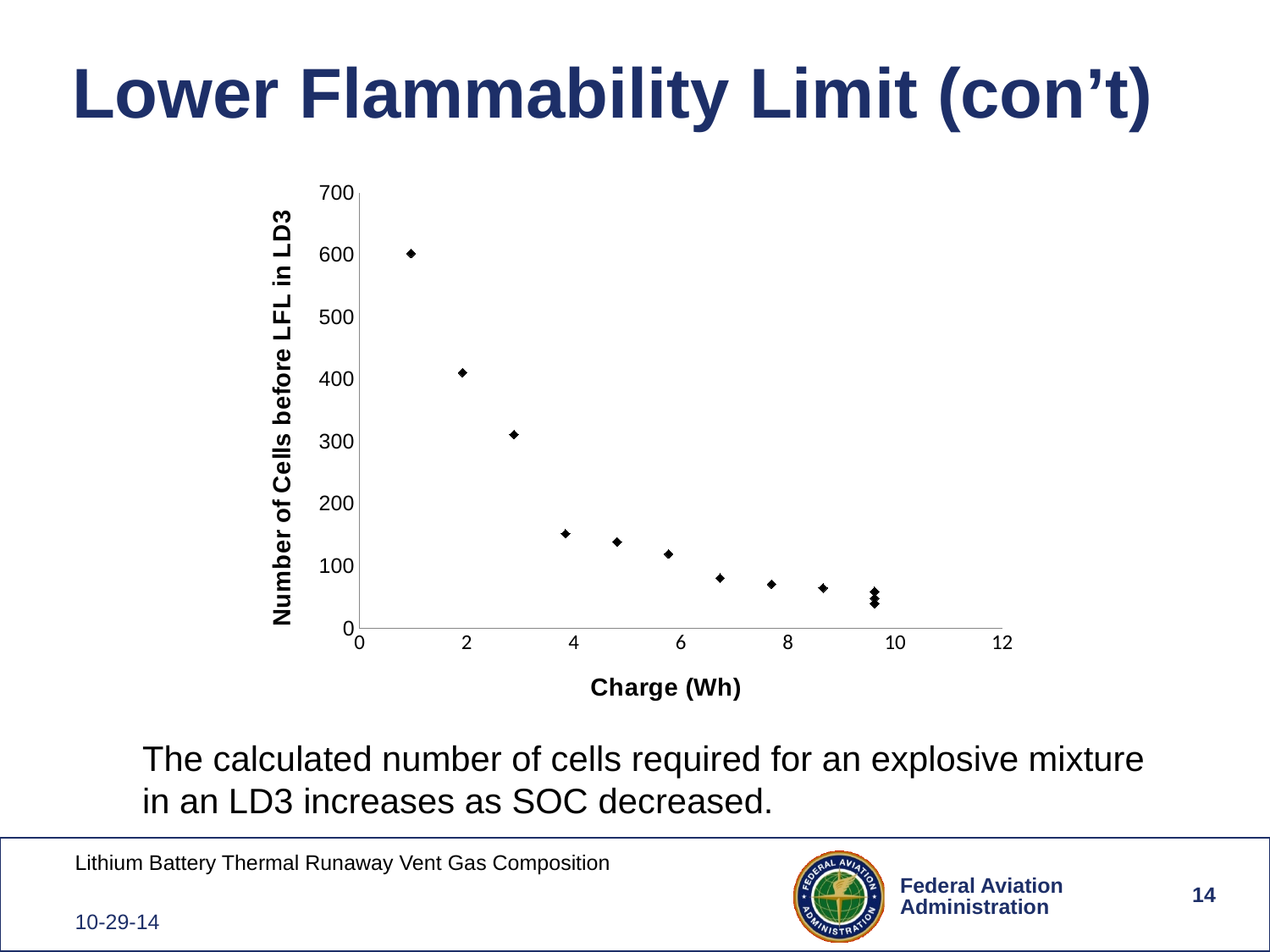
What is the label of the x axis? Charge (Wh) What kind of chart is shown on the slide? scatter chart What is the label of the y axis? Number of Cells before LFL in LD3 Is the number of cells for the point at about 3 Wh greater or less than 400? less As charge (Wh) increases along the x axis, does the number of cells before LFL rise or fall? fall Is the number of cells for the point at about 4 Wh greater or less than 200? less Is the number of cells for the point at about 8 Wh greater or less than 100? less Does the highest number of cells before LFL occur at the lowest or the highest charge? lowest charge Which has more cells before LFL: the point at about 2 Wh or the point at about 6 Wh? the point at about 2 Wh